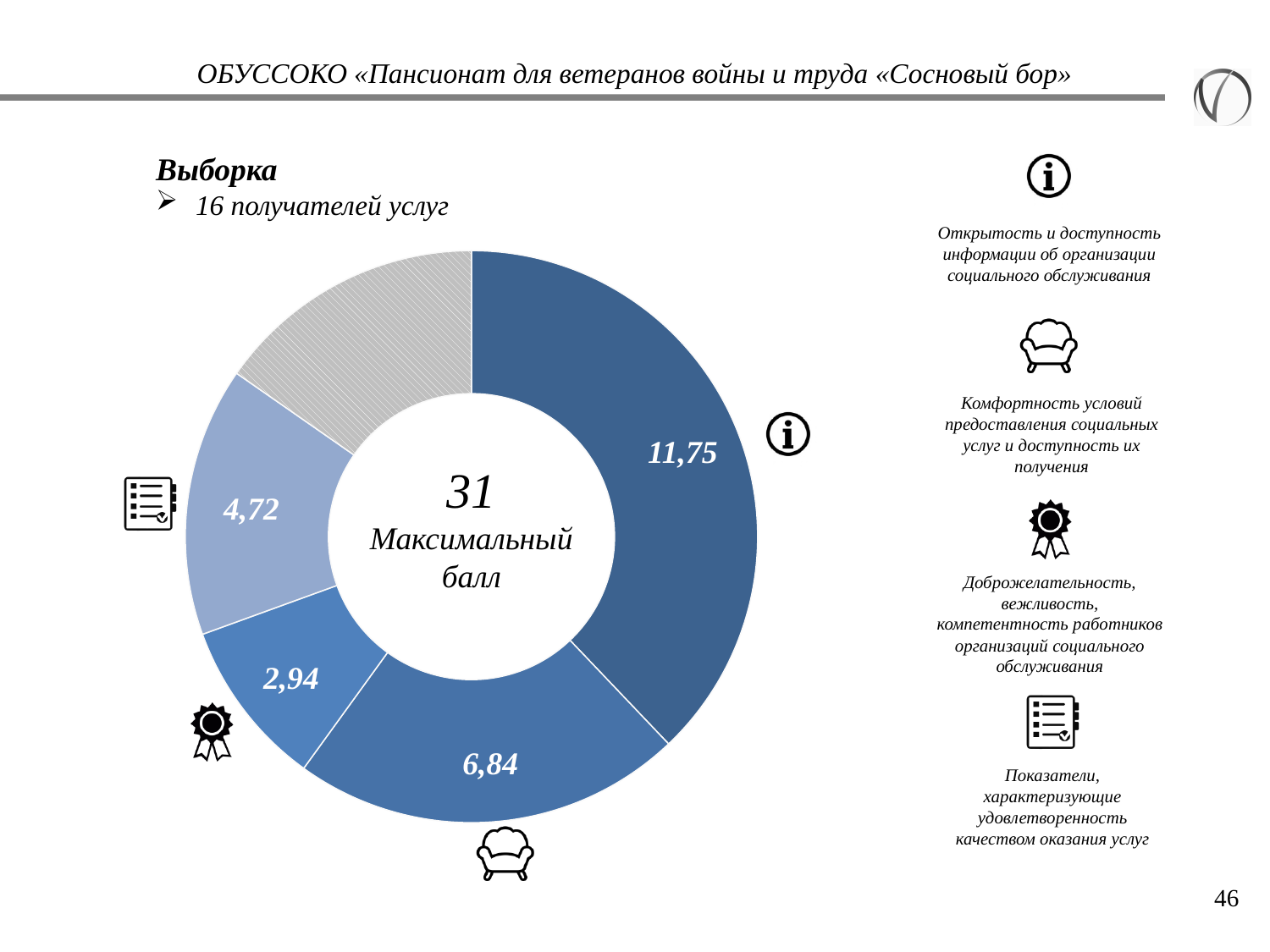
What is the difference between the value for the information icon slice (11,75) and the armchair icon slice (6,84)? 4,91 What value is shown for the slice marked with the checklist icon (Показатели, характеризующие удовлетворенность качеством оказания услуг)? 4,72 Which labeled slice has the highest value? 11,75 (Открытость и доступность информации) What value is shown for the slice marked with the information icon (Открытость и доступность информации об организации социального обслуживания)? 11,75 What value is shown for the slice marked with the medal icon (Доброжелательность, вежливость, компетентность работников)? 2,94 Which is larger: the value for the checklist icon slice or the medal icon slice? The checklist icon slice (4,72) What number is printed in the centre of the doughnut chart? 31 What value is shown for the slice marked with the armchair icon (Комфортность условий предоставления социальных услуг и доступность их получения)? 6,84 How many slices of the doughnut have a printed value label? 4 What kind of chart is shown on the slide? Doughnut chart Which labeled slice has the lowest value? 2,94 (Доброжелательность, вежливость, компетентность работников) What does the text in the centre of the doughnut say the number 31 represents? Максимальный балл